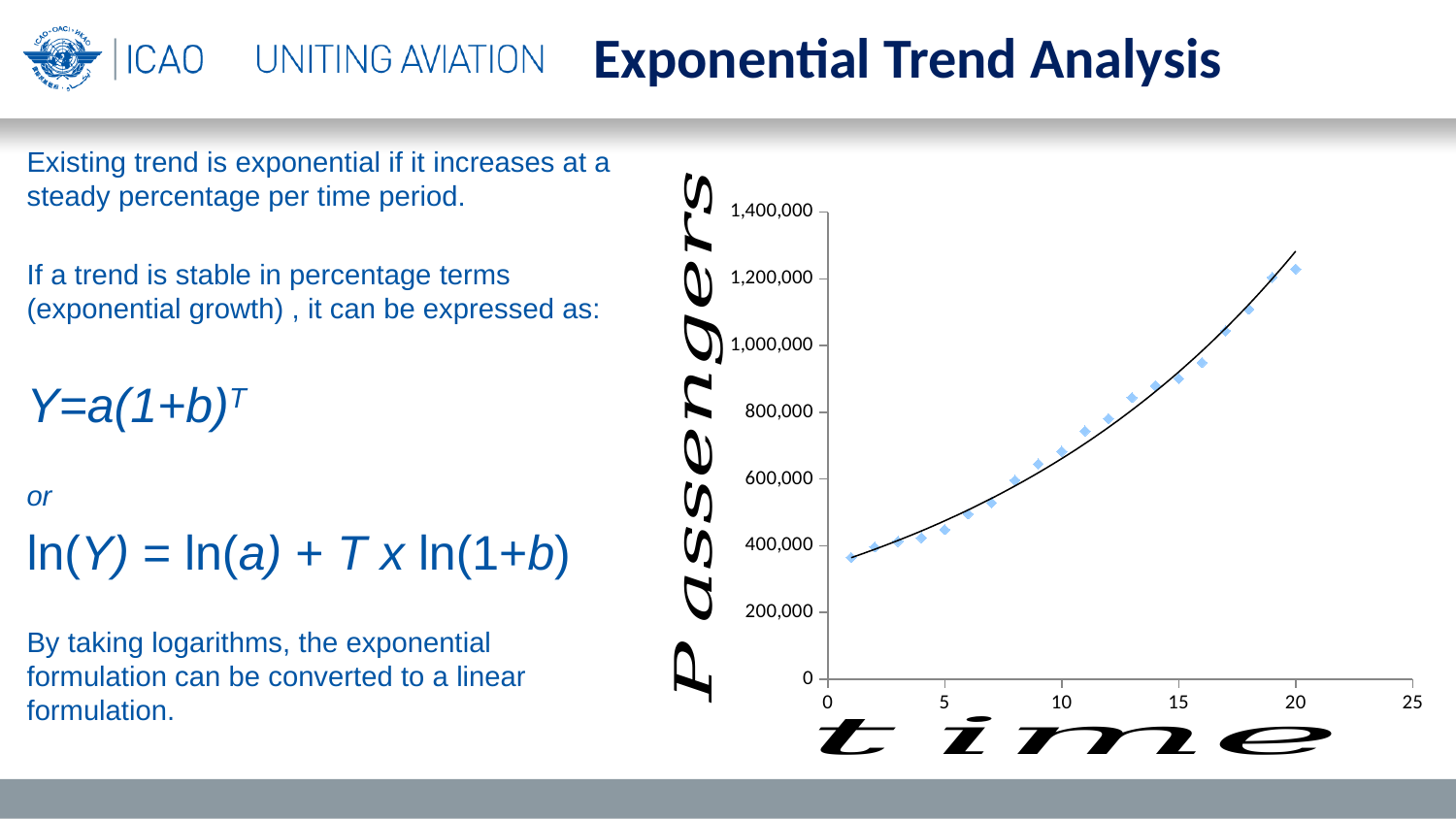
At which time value is the plotted passenger value lowest? 1 What is the label of the horizontal axis of the chart? time Is the passenger value at time 19 greater or less than 1,400,000? less Is the passenger value at time 5 greater or less than 600,000? less Is the passenger value at time 10 greater or less than 600,000? greater Which has the larger passenger value, time 5 or time 15? time 15 What is the label of the vertical axis of the chart? Passengers What kind of chart is shown on the slide? scatter chart Do the plotted passenger values rise or fall as time increases? rise At which time value is the plotted passenger value highest? 20